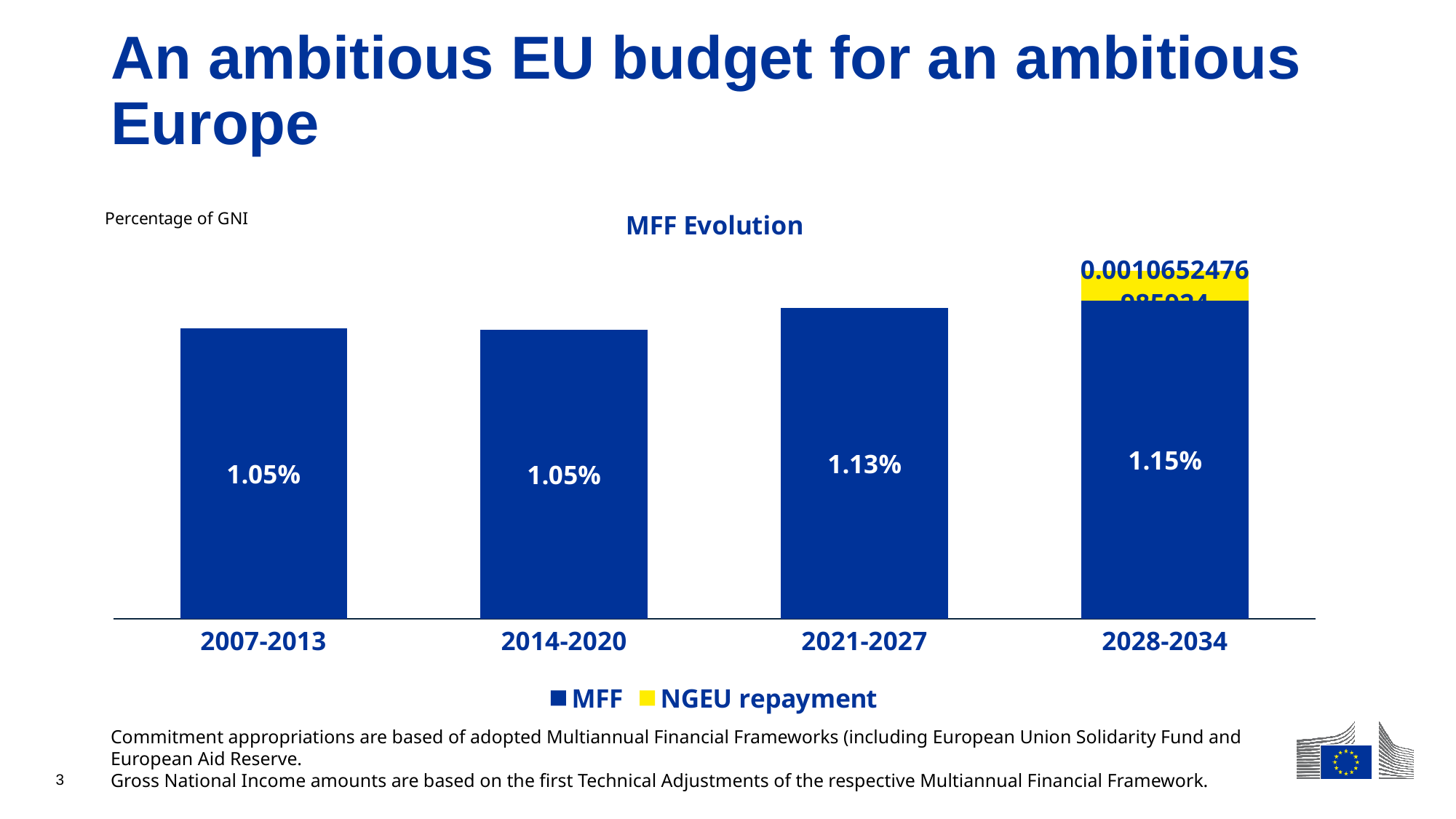
Do the MFF values rise or fall from 2007-2013 to 2028-2034? Rise How many series does the legend list? 2 What is the difference between the MFF value for 2028-2034 and for 2021-2027? 0.02 percentage points What kind of chart is shown? Stacked bar chart What is the title of the chart? MFF Evolution Which period has the highest MFF value? 2028-2034 What is the MFF value for 2021-2027? 1.13% How many periods are shown on the x axis? 4 What is the difference between the MFF value for 2021-2027 and for 2014-2020? 0.08 percentage points What is the MFF value for 2028-2034? 1.15% What is the MFF value for 2007-2013? 1.05% Which is larger, the MFF value for 2021-2027 or for 2014-2020? 2021-2027